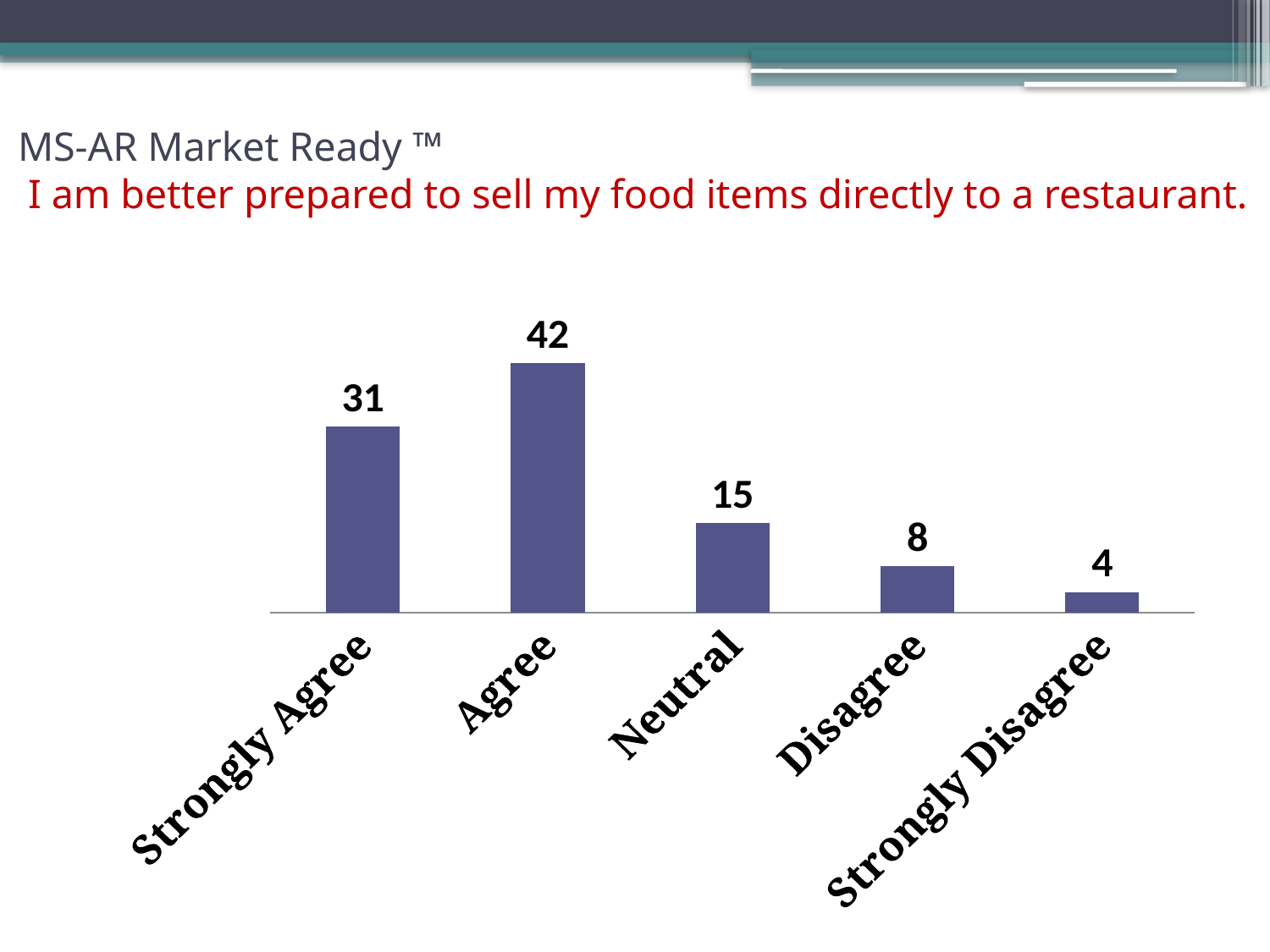
How many categories are shown on the x axis? 5 What is the difference between the values for Agree and Strongly Agree? 11 Which category has the lowest value? Strongly Disagree Which is larger, the value for Neutral or the value for Disagree? Neutral What kind of chart is shown on the slide? Bar chart What is the value for Agree? 42 What is the value for Neutral? 15 Do the values rise or fall from Agree to Strongly Disagree along the x axis? Fall What is the value for Strongly Disagree? 4 What is the value for Strongly Agree? 31 What is the value for Disagree? 8 Which category has the highest value? Agree